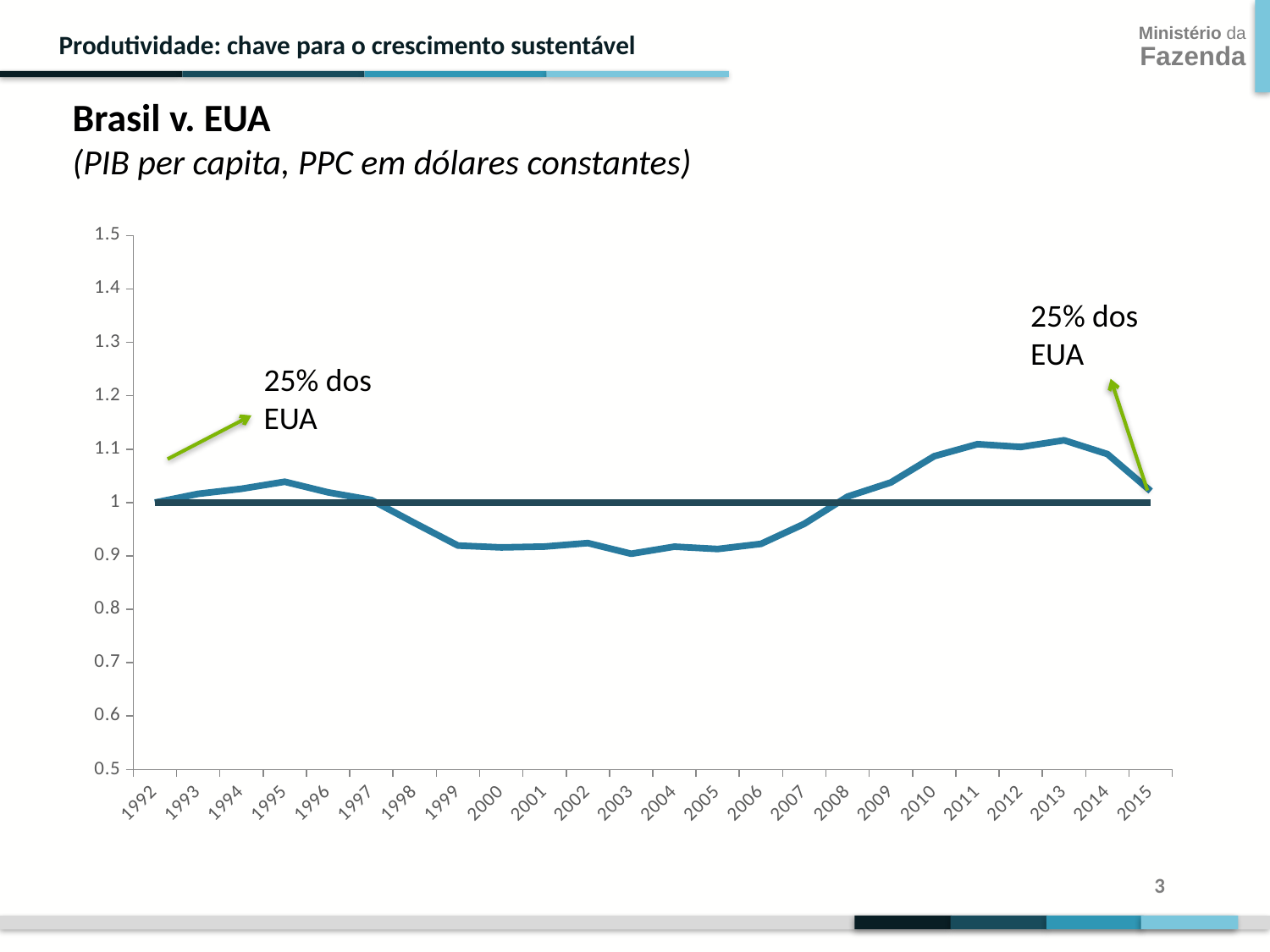
Which is larger, the value for 1995 or the value for 1999? 1995 How many years are shown on the x axis of the chart? 24 Is the value for 1995 greater or less than 1? greater Is the value for 2010 greater or less than 1? greater What is the last year shown on the x axis? 2015 Is the value for 1999 greater or less than 1? less Do the values rise or fall from 2007 to 2011? rise What is the first year shown on the x axis? 1992 Do the values rise or fall from 2013 to 2015? fall Which is larger, the value for 2013 or the value for 2003? 2013 What kind of chart is shown on the slide? line chart